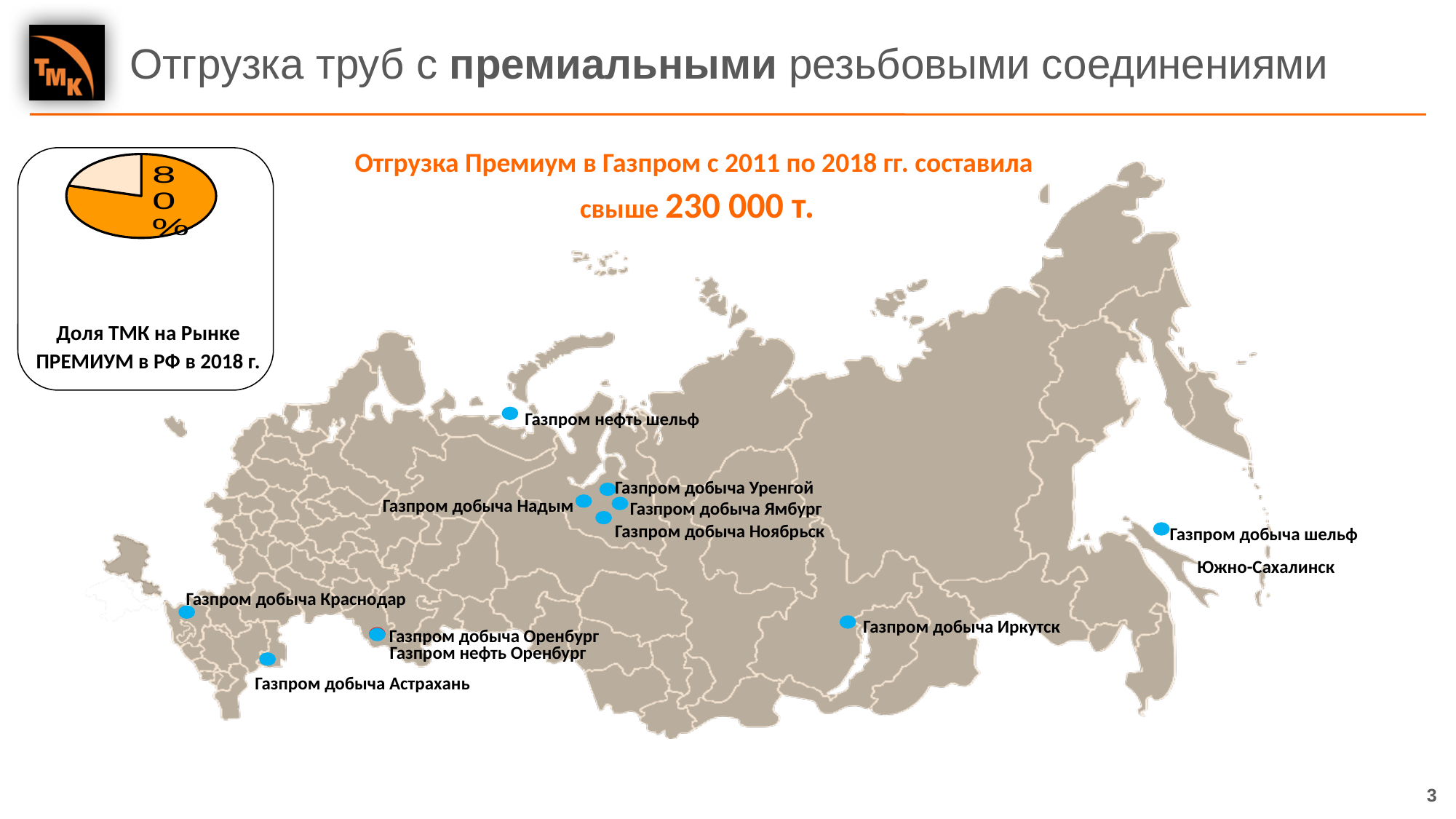
What share of the pie chart is labelled on the orange slice? 80% What kind of chart is shown in the box on the left of the slide? pie chart What caption is written under the pie chart? Доля ТМК на Рынке ПРЕМИУМ в РФ в 2018 г. Which slice of the pie chart is larger, the orange one or the light one? the orange one How many slices does the pie chart have? 2 What colour is the largest slice of the pie chart? orange Is the share shown on the labelled slice of the pie chart greater or less than 50%? greater